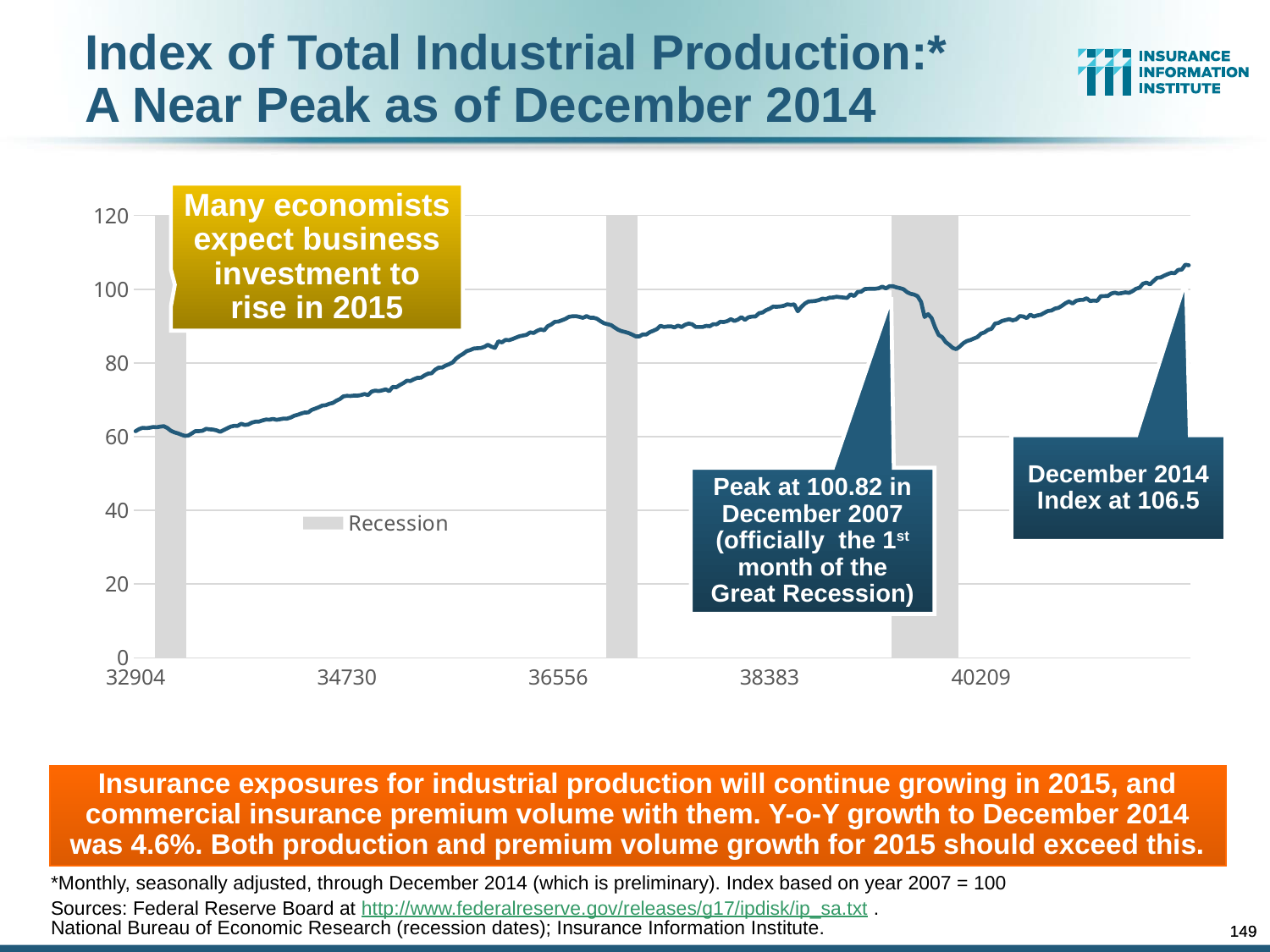
What was the Index of Total Industrial Production in December 2014, according to the callout? 106.5 Over the whole period shown, does the index generally rise or fall from left to right? rise Is the index value at the x-axis label 40209 greater or less than 100? less What does the gray shading on the chart represent, according to the legend? Recession Is the index value at the x-axis label 36556 greater or less than 80? greater What is the highest value shown on the vertical axis? 120 What was the peak value of the index in December 2007, according to the callout? 100.82 How many shaded recession periods are marked on the chart? 3 What kind of chart is shown on the slide? line chart Which is higher: the index in December 2007 or the index in December 2014? December 2014 By how much does the December 2014 index value exceed the December 2007 peak? 5.68 Is the index value at the start of the series (x-axis label 32904) greater or less than 80? less